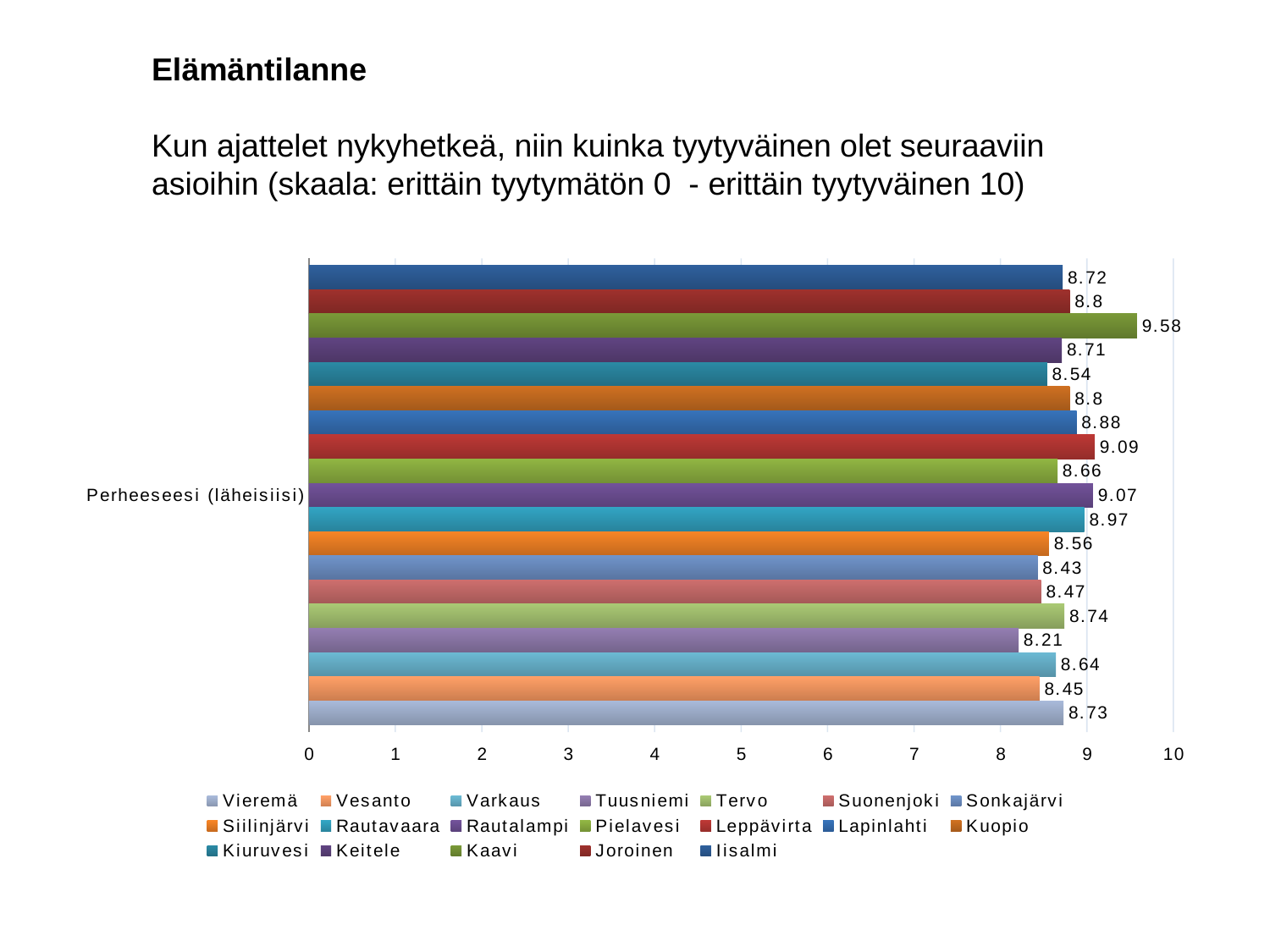
What is the difference between the values for Kaavi and Tuusniemi? 1.37 How many series does the legend list? 19 What is the value for Tuusniemi? 8.21 What kind of chart is shown on the slide? bar chart Which is larger, the value for Rautalampi or the value for Rautavaara? Rautalampi Which municipality has the highest value? Kaavi What is the value for Leppävirta? 9.09 What is the value for Vieremä? 8.73 What is the category label shown on the vertical axis? Perheeseesi (läheisiisi) What is the value for Kaavi? 9.58 Is the value for Lapinlahti greater or less than 9? less Which municipality has the lowest value? Tuusniemi